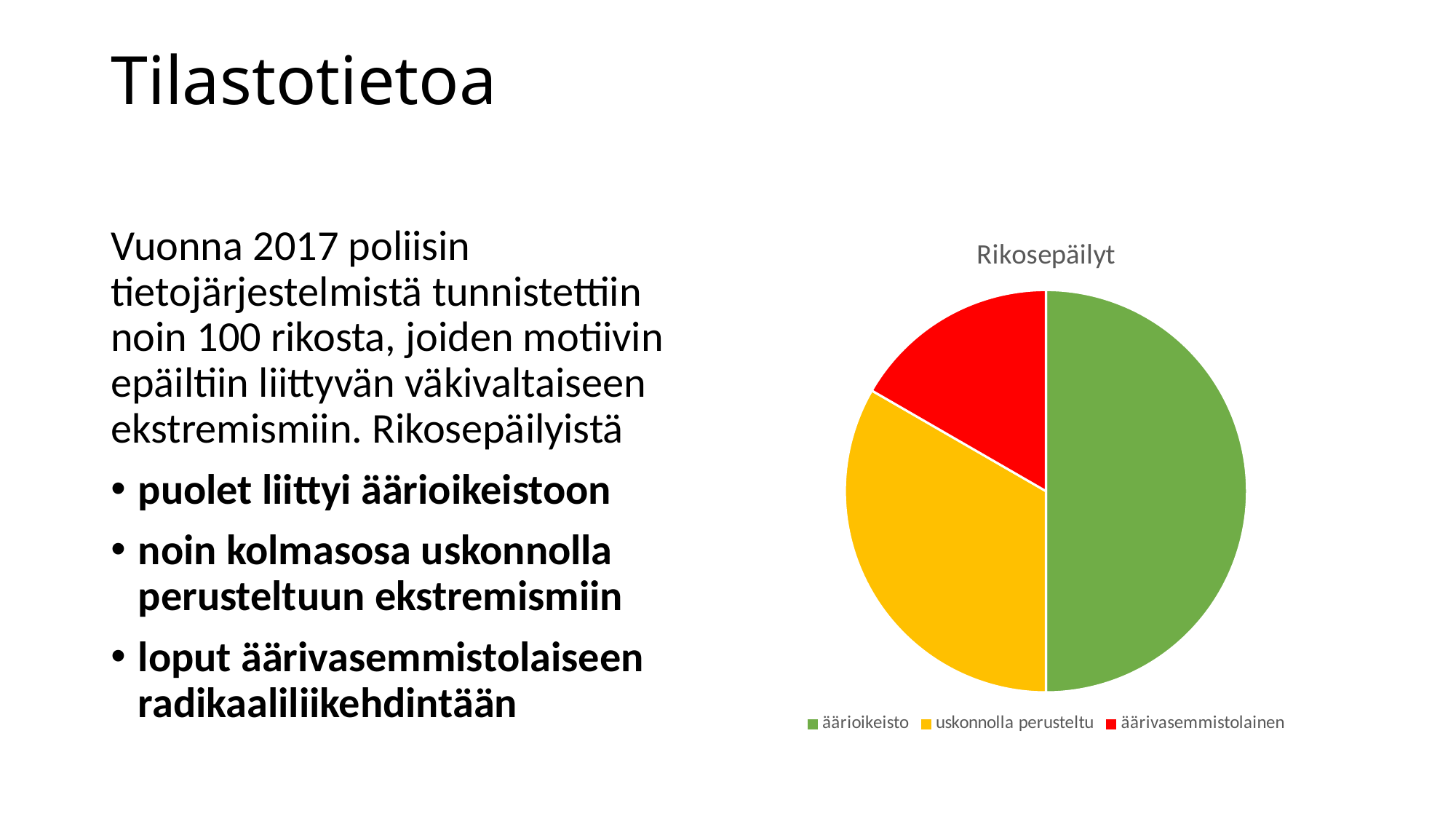
What is the title of the chart? Rikosepäilyt Which slice is larger, äärioikeisto or uskonnolla perusteltu? äärioikeisto Which category has the smallest slice of the pie? äärivasemmistolainen What kind of chart is shown on the slide? pie chart Which slice is larger, uskonnolla perusteltu or äärivasemmistolainen? uskonnolla perusteltu What colour is the slice for äärioikeisto? green How many slices does the pie chart have? 3 Which category has the largest slice of the pie? äärioikeisto How many entries does the chart legend list? 3